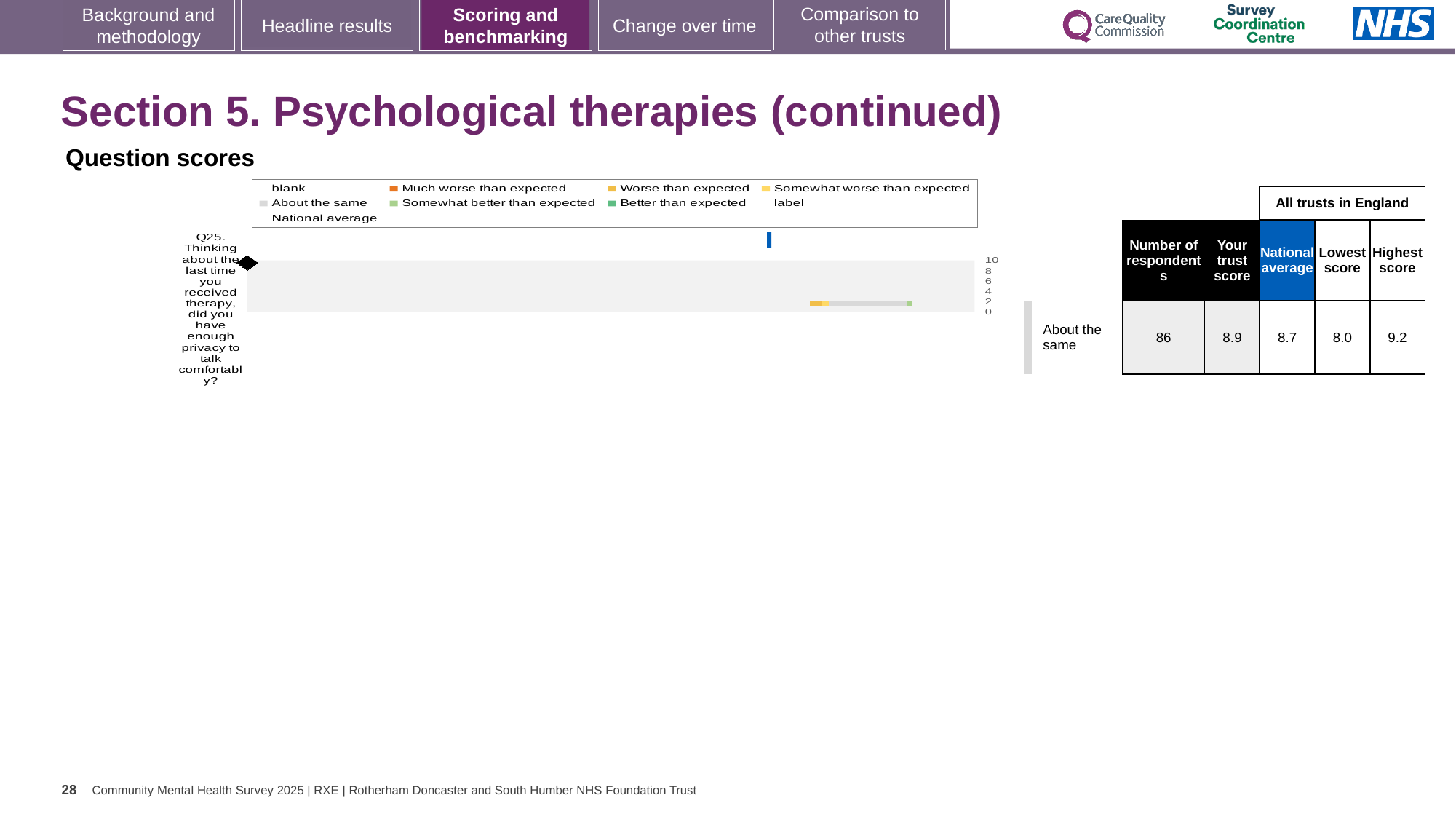
What is the lowest score among all trusts in England for Q25? 8.0 How many questions are plotted in the Question scores chart? 1 What is the trust score for Q25? 8.9 Which is larger for Q25, the trust score or the national average? the trust score What is the highest score among all trusts in England for Q25? 9.2 What is the difference between the highest and lowest scores among all trusts in England for Q25? 1.2 What kind of chart is shown under 'Question scores'? bar chart What is the national average score for Q25? 8.7 How many respondents answered Q25? 86 What is the difference between the trust score and the national average for Q25? 0.2 Which question is plotted in the Question scores chart? Q25. Thinking about the last time you received therapy, did you have enough privacy to talk comfortably? Which benchmark category is the trust's Q25 score placed in? About the same